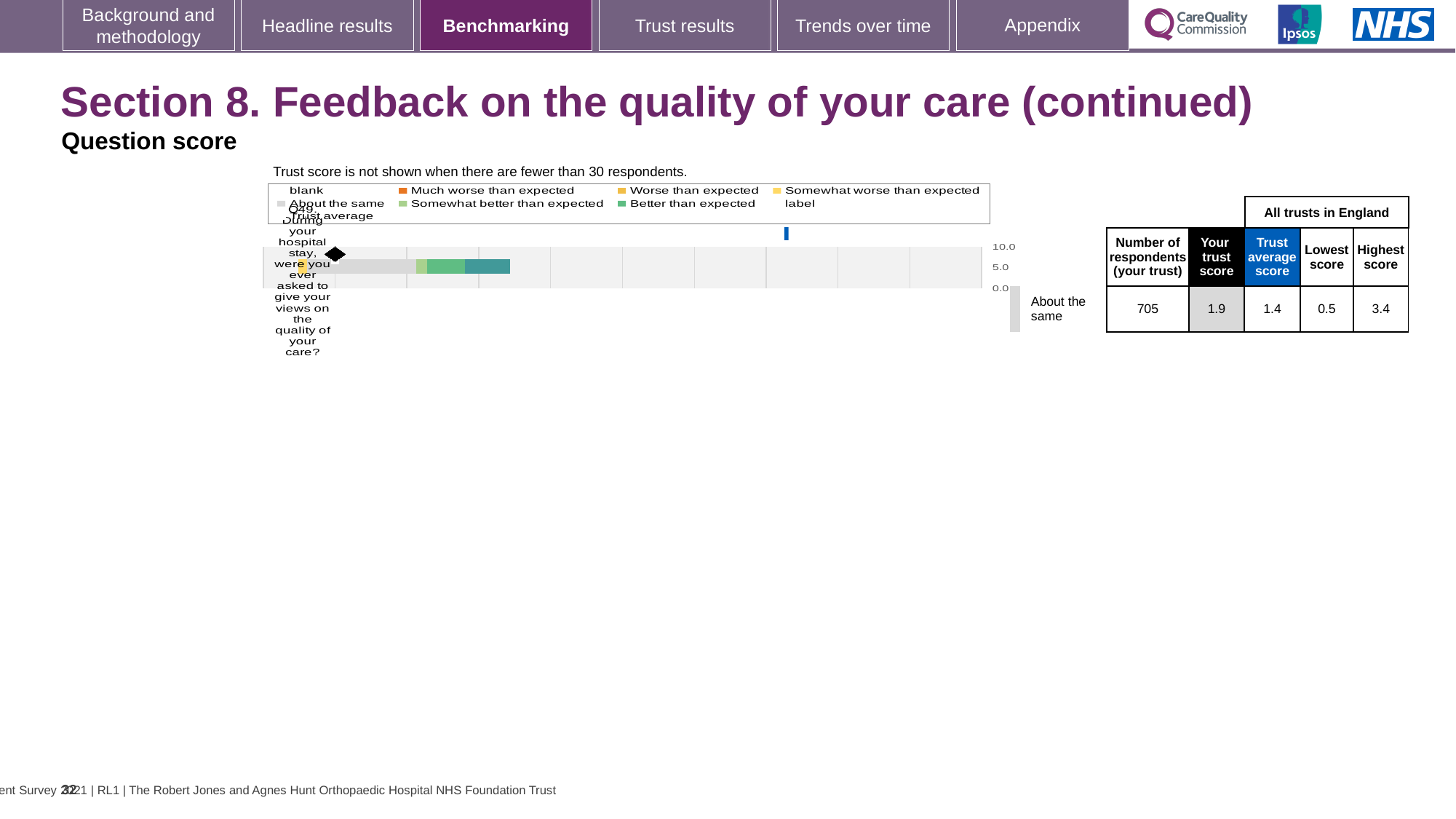
In the table beside the chart, what is the highest score among all trusts in England? 3.4 Which question number is plotted in the bar chart? Q49 In the table beside the chart, what is the lowest score among all trusts in England? 0.5 What benchmark category label is shown next to the chart for Q49? About the same Which is larger for Q49: your trust score or the trust average score? Your trust score What kind of chart is shown on the slide? bar chart What is the difference between the highest score and the lowest score among all trusts in England for Q49? 2.9 In the table beside the chart, what is the trust average score for Q49? 1.4 How many questions are plotted in the bar chart? 1 In the table beside the chart, what is the number of respondents for your trust? 705 In the table beside the chart, what is your trust score for Q49? 1.9 By how much does your trust score exceed the trust average score for Q49? 0.5